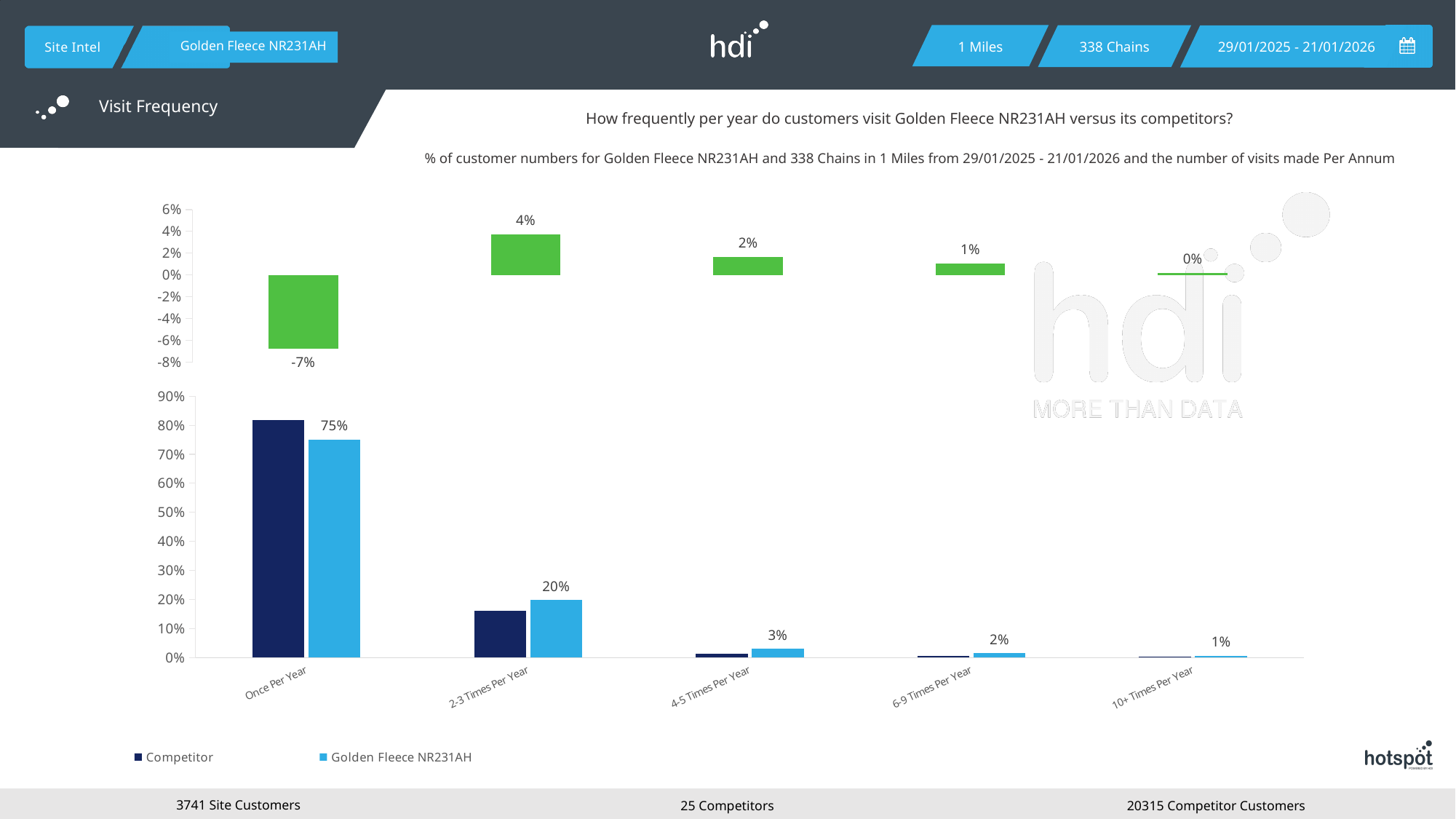
In the top green chart, what is the value of the first (leftmost) bar? -7% How many categories are shown on the x axis of the bottom bar chart? 5 In the bottom bar chart, which category has the lowest value for Golden Fleece NR231AH? 10+ Times Per Year In the bottom bar chart, what is the difference between the Golden Fleece NR231AH values for Once Per Year and 2-3 Times Per Year? 55 percentage points In the bottom bar chart, is the Competitor value for 2-3 Times Per Year greater or less than 20%? less In the bottom bar chart, what is the value for Golden Fleece NR231AH in the Once Per Year category? 75% How many series does the legend of the bottom bar chart list? 2 In the bottom bar chart, which category has the highest value for Golden Fleece NR231AH? Once Per Year In the bottom bar chart, for the Once Per Year category, which series has the larger value: Competitor or Golden Fleece NR231AH? Competitor In the bottom bar chart, what is the value for Golden Fleece NR231AH in the 4-5 Times Per Year category? 3% In the bottom bar chart, is the Competitor value for Once Per Year greater or less than 80%? greater In the bottom bar chart, what is the value for Golden Fleece NR231AH in the 2-3 Times Per Year category? 20%